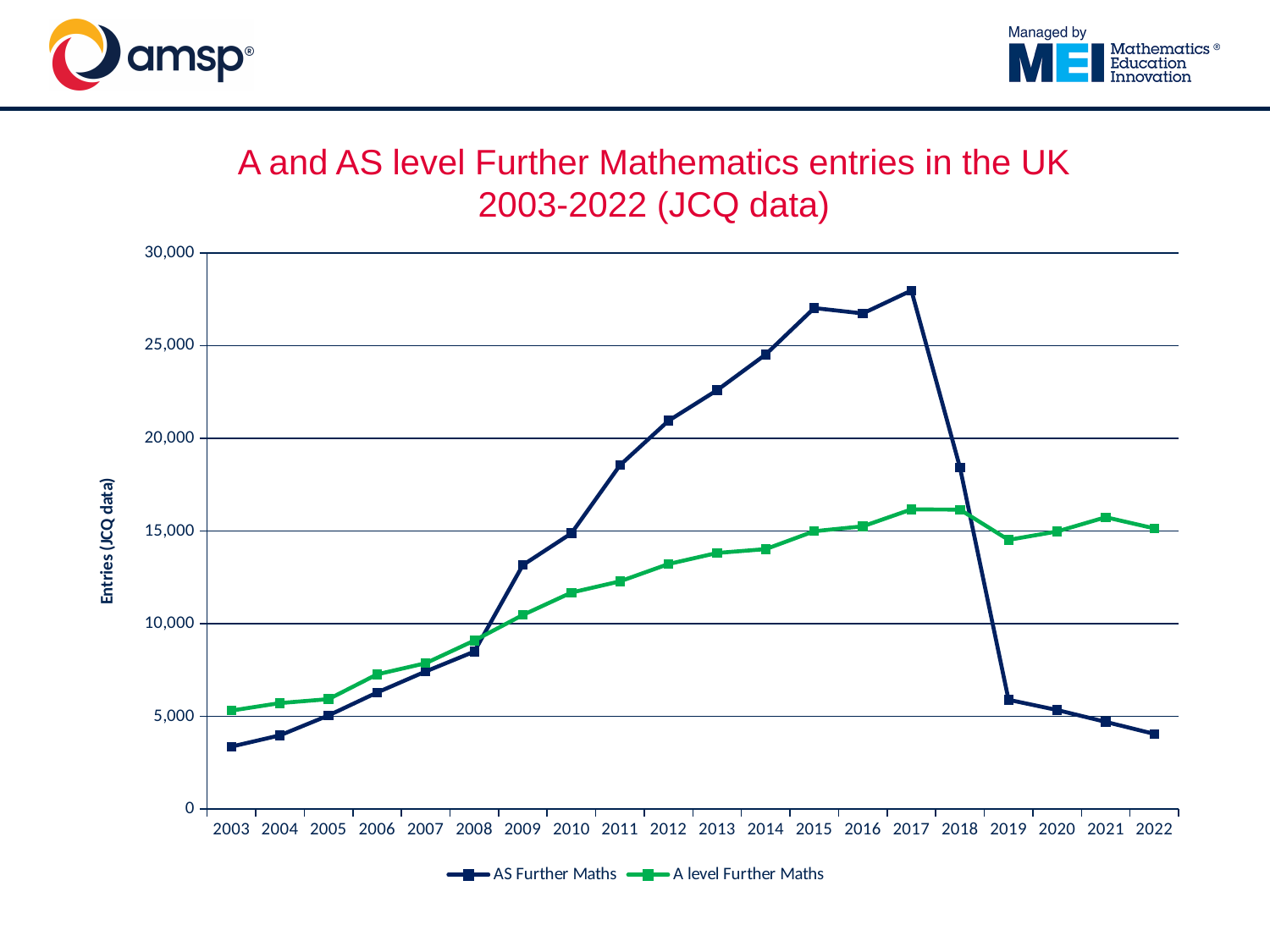
How many series does the legend list? 2 What is the label on the vertical axis? Entries (JCQ data) In which year does the AS Further Maths series reach its highest value? 2017 How many years are plotted along the x axis? 20 Is the value for AS Further Maths in 2017 greater or less than 25,000? greater What kind of chart is shown on the slide? line chart In which year is the AS Further Maths series at its lowest value? 2003 Is the value for AS Further Maths in 2019 greater or less than 10,000? less Which series has the larger value in 2020, AS Further Maths or A level Further Maths? A level Further Maths Which series has the larger value in 2015, AS Further Maths or A level Further Maths? AS Further Maths